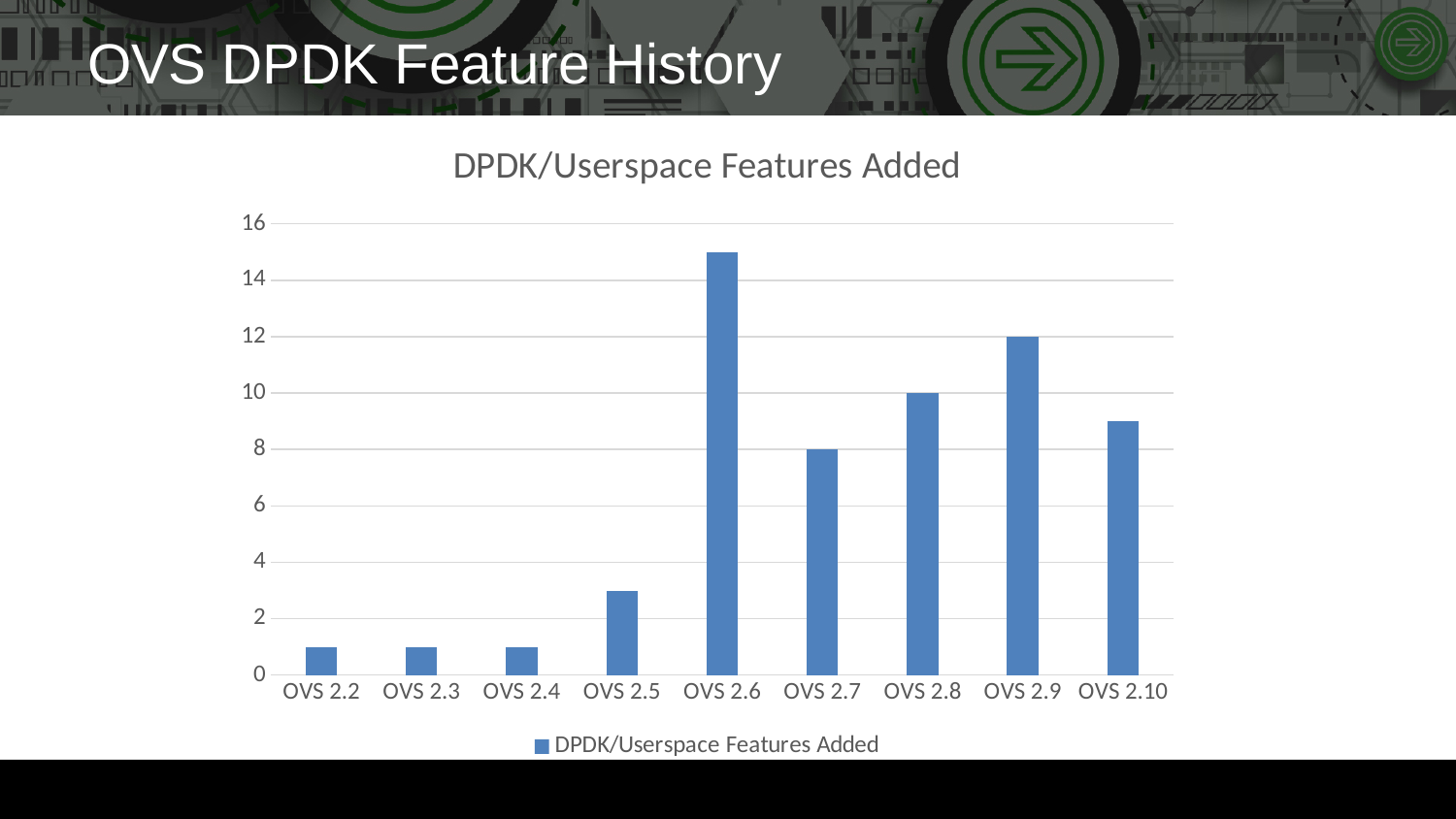
How many DPDK/Userspace features were added in OVS 2.7? 8 How many series does the legend list? 1 Which has more features added, OVS 2.9 or OVS 2.8? OVS 2.9 What is the title of the chart? DPDK/Userspace Features Added Which OVS version has the highest number of DPDK/Userspace features added? OVS 2.6 Is the value for OVS 2.2 greater or less than 2? less What is the difference between the features added in OVS 2.9 and OVS 2.7? 4 Is the value for OVS 2.6 greater or less than 14? greater How many DPDK/Userspace features were added in OVS 2.8? 10 How many DPDK/Userspace features were added in OVS 2.9? 12 How many OVS versions are shown on the x axis? 9 What type of chart is shown on the slide? bar chart